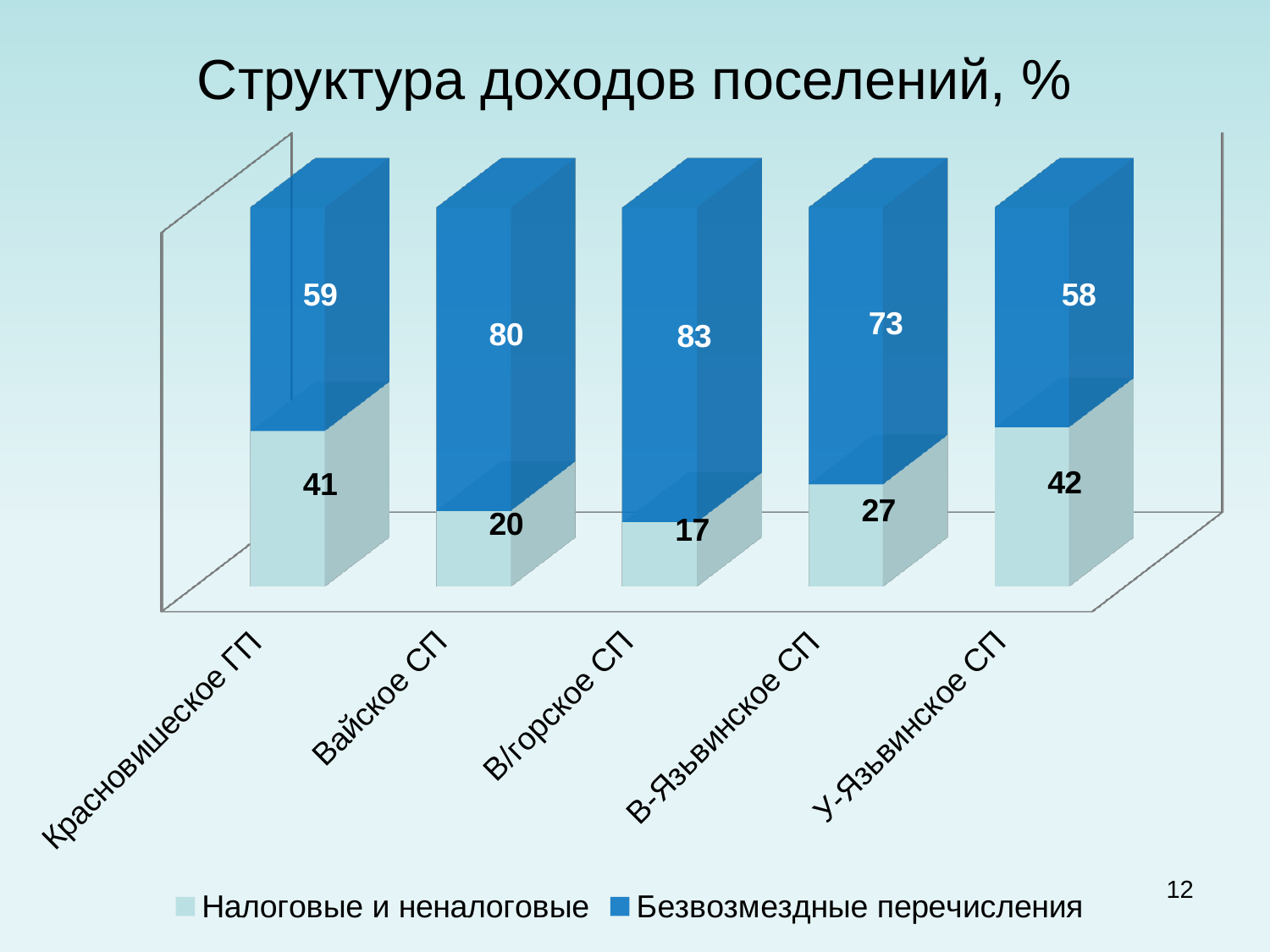
What is the value of "Налоговые и неналоговые" for Красновишерское ГП? 41 What is the value of "Безвозмездные перечисления" for В/горское СП? 83 Which category has the highest value for "Безвозмездные перечисления"? В/горское СП What is the value of "Налоговые и неналоговые" for В-Язьвинское СП? 27 Which category has the lowest value for "Налоговые и неналоговые"? В/горское СП What kind of chart is shown on the slide? Stacked bar chart What is the value of "Безвозмездные перечисления" for У-Язьвинское СП? 58 Which is larger: "Налоговые и неналоговые" for У-Язьвинское СП or for Красновишерское ГП? У-Язьвинское СП How many series does the legend list? 2 What is the title of the chart? Структура доходов поселений, % How many categories are shown on the x axis? 5 What is the difference between the "Безвозмездные перечисления" values for Вайское СП and Красновишерское ГП? 21